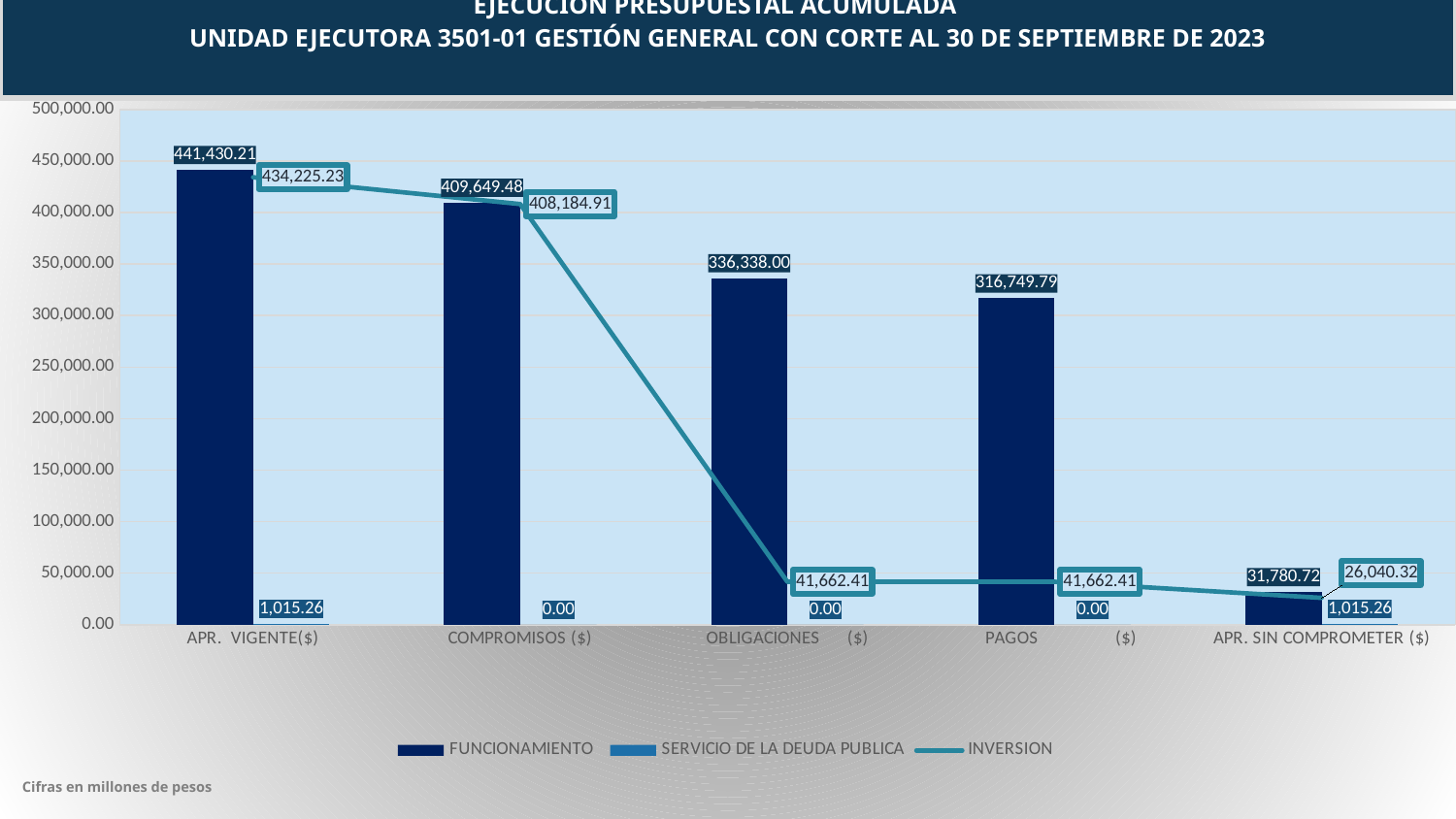
How many categories are shown on the x axis? 5 Does the INVERSION line rise or fall from APR. VIGENTE($) to APR. SIN COMPROMETER ($)? fall Which category has the lowest INVERSION value? APR. SIN COMPROMETER ($) What is the SERVICIO DE LA DEUDA PUBLICA value for APR. SIN COMPROMETER ($)? 1,015.26 Which category has the highest FUNCIONAMIENTO value? APR. VIGENTE($) Is the FUNCIONAMIENTO value for COMPROMISOS ($) greater or less than 400,000.00? greater What is the FUNCIONAMIENTO value for PAGOS ($)? 316,749.79 How many series does the legend list? 3 What is the INVERSION value for COMPROMISOS ($)? 408,184.91 What is the FUNCIONAMIENTO value for APR. VIGENTE($)? 441,430.21 What is the difference between the FUNCIONAMIENTO values for OBLIGACIONES ($) and PAGOS ($)? 19,588.21 Which is larger for OBLIGACIONES ($): the FUNCIONAMIENTO value or the INVERSION value? FUNCIONAMIENTO